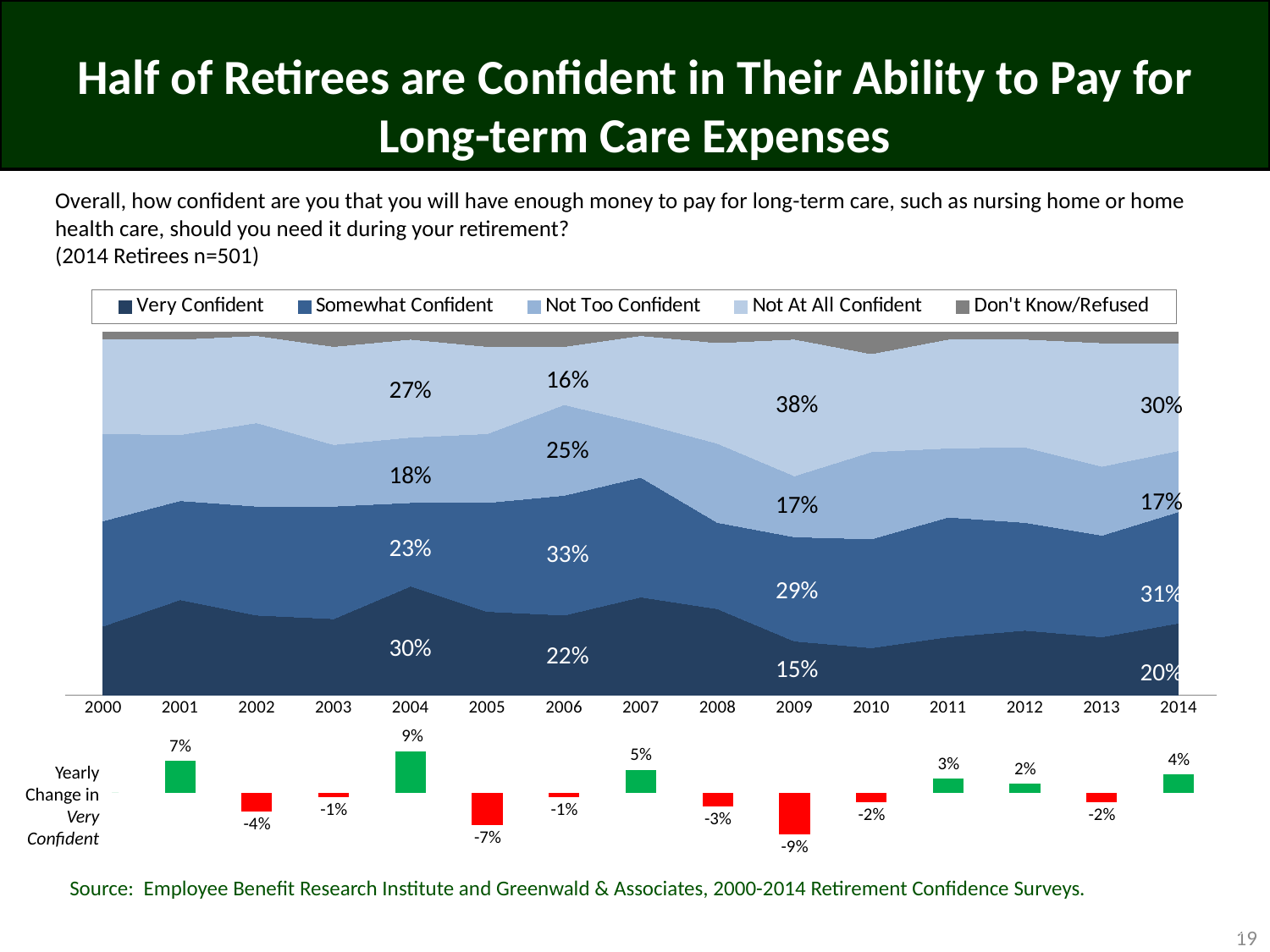
In the bottom bar chart, what is the yearly change in Very Confident for 2007? 5% In the bottom bar chart, what is the yearly change in Very Confident for 2013? -2% In the top stacked area chart, what percentage of retirees were Very Confident in 2014? 20% In the bottom bar chart of yearly change in Very Confident, which year has the largest increase? 2004 How many series does the legend of the top stacked area chart list? 5 In the top stacked area chart, how many years are shown on the x axis? 15 What kind of chart is the bottom chart showing yearly change in Very Confident? Bar chart In the top stacked area chart, what percentage of retirees were Not Too Confident in 2004? 18% In the top stacked area chart, what is the difference between the Very Confident share in 2004 and in 2009? 15% In the top stacked area chart, what percentage of retirees were Somewhat Confident in 2006? 33% In the top stacked area chart, what percentage of retirees were Not At All Confident in 2009? 38% In the bottom bar chart of yearly change in Very Confident, which year has the largest decrease? 2009